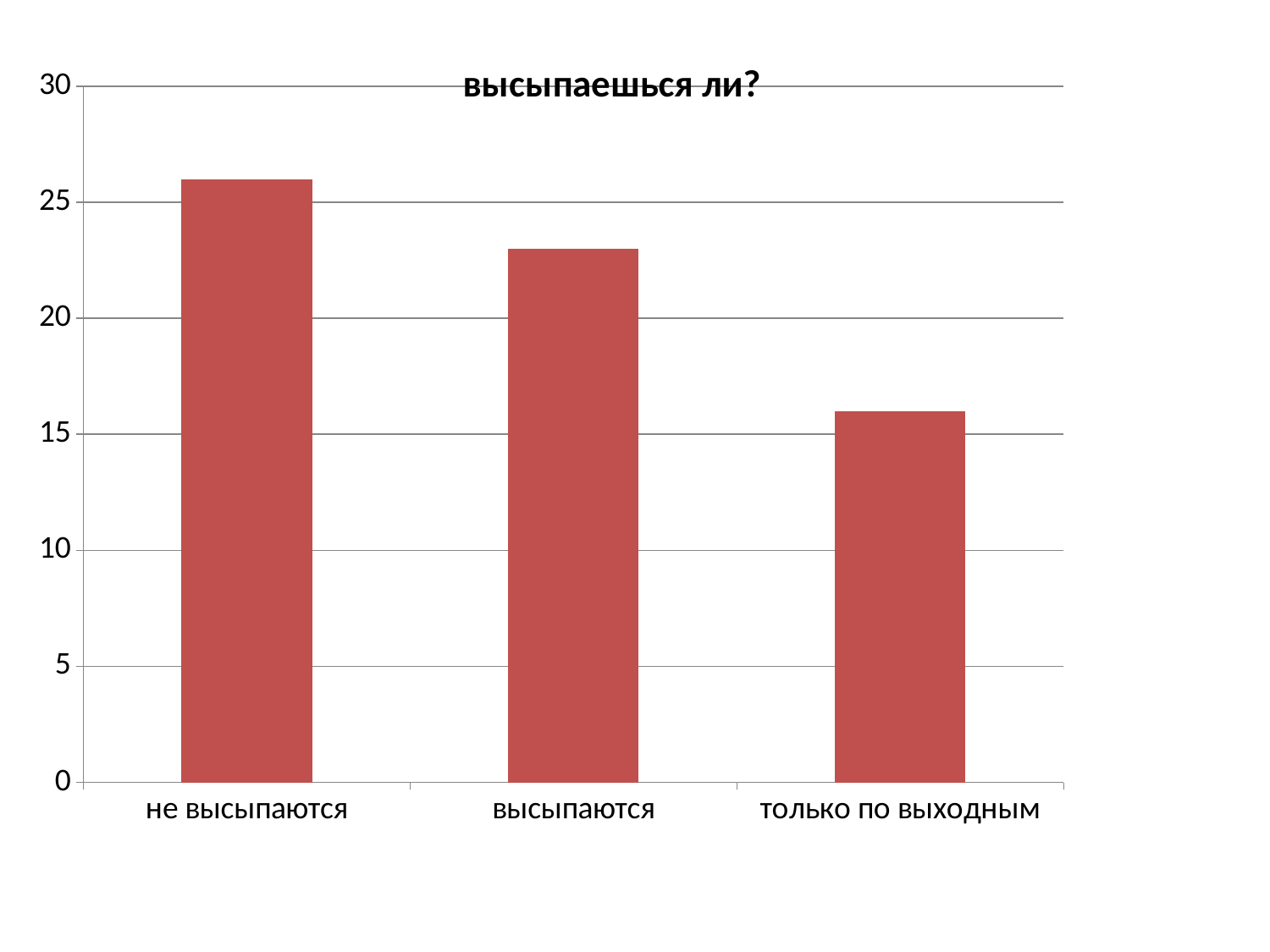
Which is larger, the value for 'не высыпаются' or the value for 'высыпаются'? не высыпаются How many categories are shown on the x axis of the chart? 3 What is the title of the chart? высыпаешься ли? Is the value for 'только по выходным' greater or less than 15? greater Is the value for 'не высыпаются' greater or less than 25? greater What kind of chart is shown on the slide? bar chart Which is larger, the value for 'высыпаются' or the value for 'только по выходным'? высыпаются Is the value for 'только по выходным' greater or less than 20? less Do the bar values rise or fall from left to right along the x axis? fall Which category has the highest bar? не высыпаются Which category has the lowest bar? только по выходным